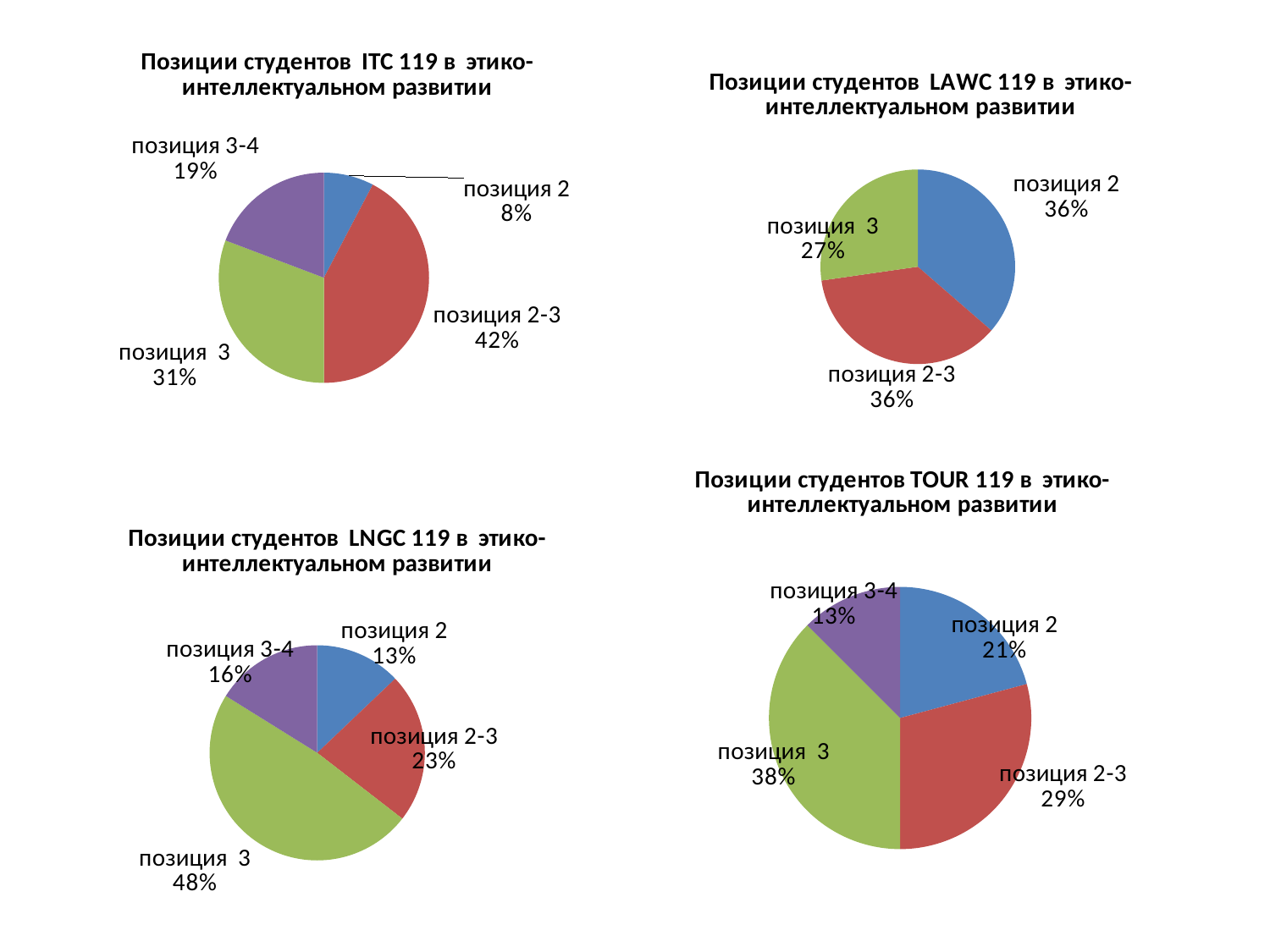
In the LNGC 119 pie chart, which is larger: позиция 2 or позиция 2-3? позиция 2-3 In the LNGC 119 pie chart, which position has the largest share? позиция 3 What type of chart is used for the TOUR 119 data? Pie chart In the TOUR 119 pie chart, what share does позиция 2 have? 21% In the ITC 119 pie chart, which position has the smallest share? позиция 2 How many slices does the LAWC 119 pie chart have? 3 In the ITC 119 pie chart, what share does позиция 2-3 have? 42% In the TOUR 119 pie chart, what is the difference between the shares of позиция 3 and позиция 2-3? 9% In the LAWC 119 pie chart, what share does позиция 3 have? 27% In the ITC 119 pie chart, what is the difference between the shares of позиция 3 and позиция 3-4? 12% In the LNGC 119 pie chart, what share does позиция 3-4 have? 16% In the LAWC 119 pie chart, what is the combined share of позиция 2 and позиция 2-3? 72%